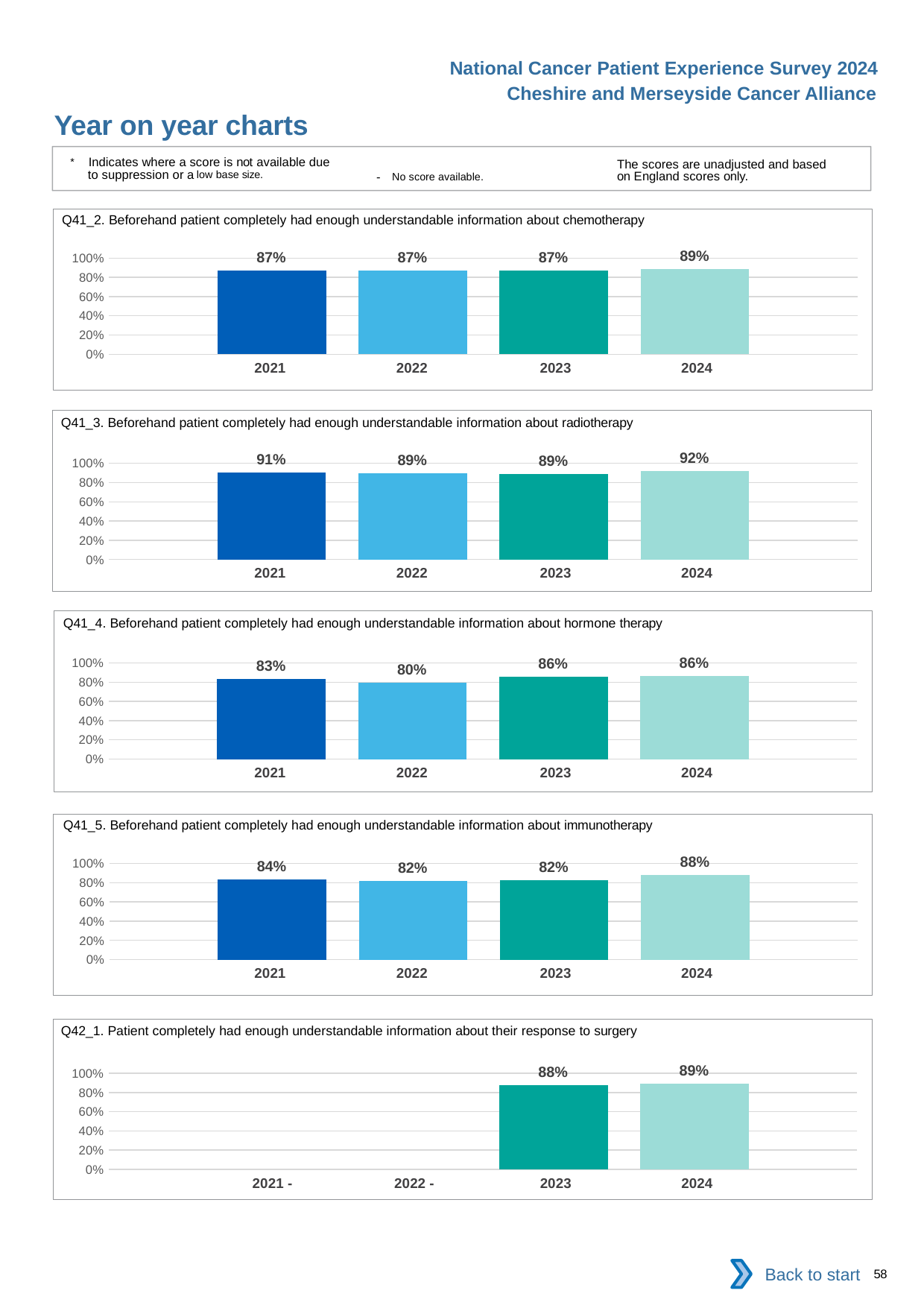
How many bars with plotted values are shown in the Q42_1 chart (response to surgery)? 2 In the Q42_1 chart (response to surgery), which is larger, the value for 2023 or 2024? 2024 How many charts are shown on the slide? 5 In the Q41_4 chart (hormone therapy), which year has the lowest value? 2022 In the Q41_4 chart (hormone therapy), what is the difference between the 2021 and 2022 values? 3% In the Q41_3 chart (radiotherapy), what is the value for 2021? 91% In the Q41_3 chart (radiotherapy), which year has the highest value? 2024 In the Q41_5 chart (immunotherapy), is the value for 2022 greater or less than 60%? greater In the Q42_1 chart (response to surgery), which years have no score available? 2021 and 2022 In the Q41_5 chart (immunotherapy), what is the difference between the 2024 and 2023 values? 6% What kind of chart is the Q41_4 chart (hormone therapy)? Bar chart In the Q41_2 chart (chemotherapy), what is the value for 2024? 89%